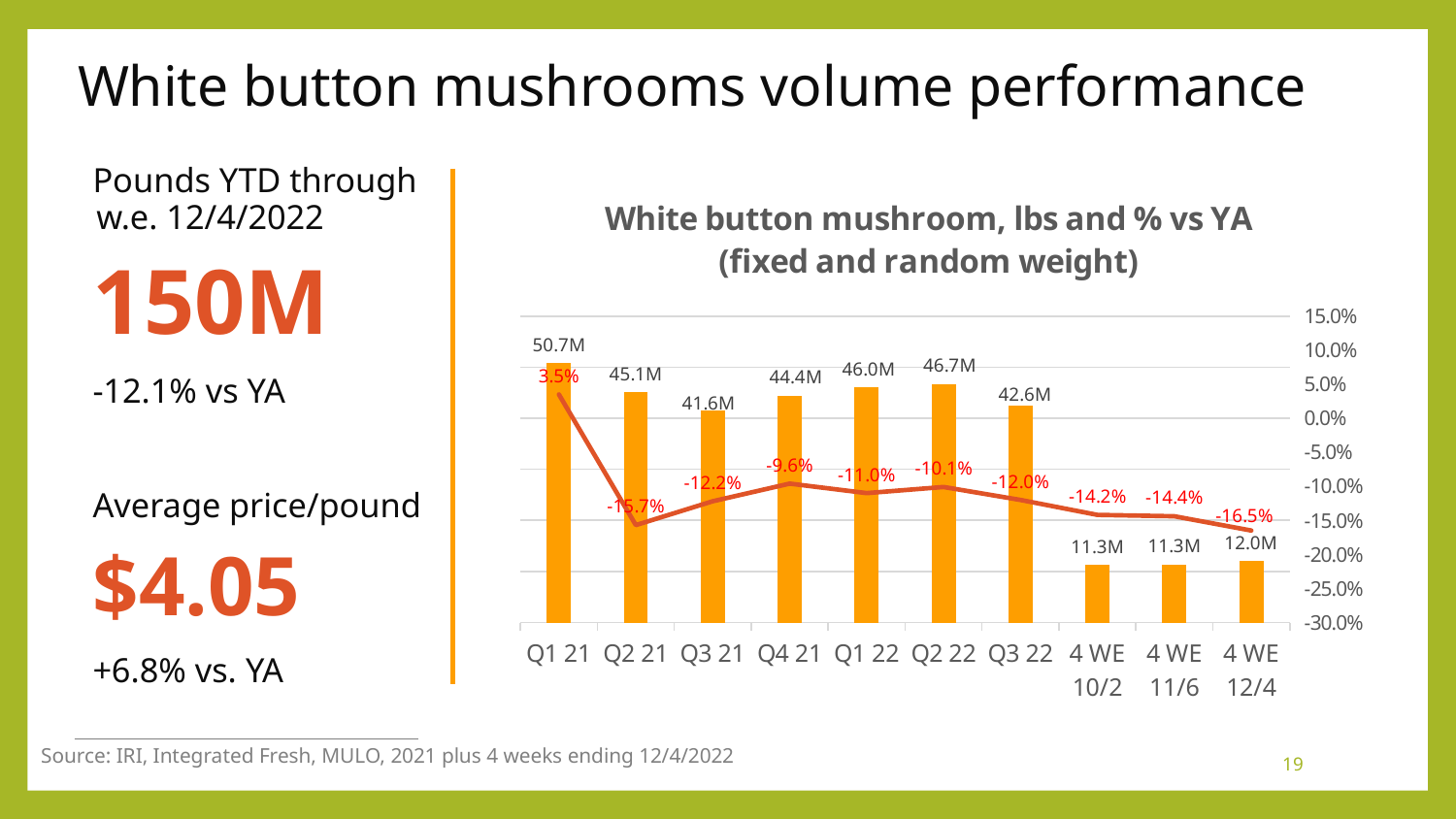
What is the volume in pounds for the 4 WE 12/4 period? 12.0M Which period has the highest volume in pounds? Q1 21 How many periods are shown on the x axis? 10 What is the volume in pounds for Q1 21? 50.7M What kind of chart is used to show the pounds values? Bar chart Which has a higher volume in pounds, Q2 22 or Q3 22? Q2 22 What is the % vs YA value for Q4 21? -9.6% Which period has the lowest % vs YA value? 4 WE 12/4 What is the title of the chart? White button mushroom, lbs and % vs YA (fixed and random weight) Is the % vs YA value for Q1 21 greater or less than 0.0%? greater What is the difference in pounds between Q1 21 and Q2 21? 5.6M What is the % vs YA value for Q2 21? -15.7%